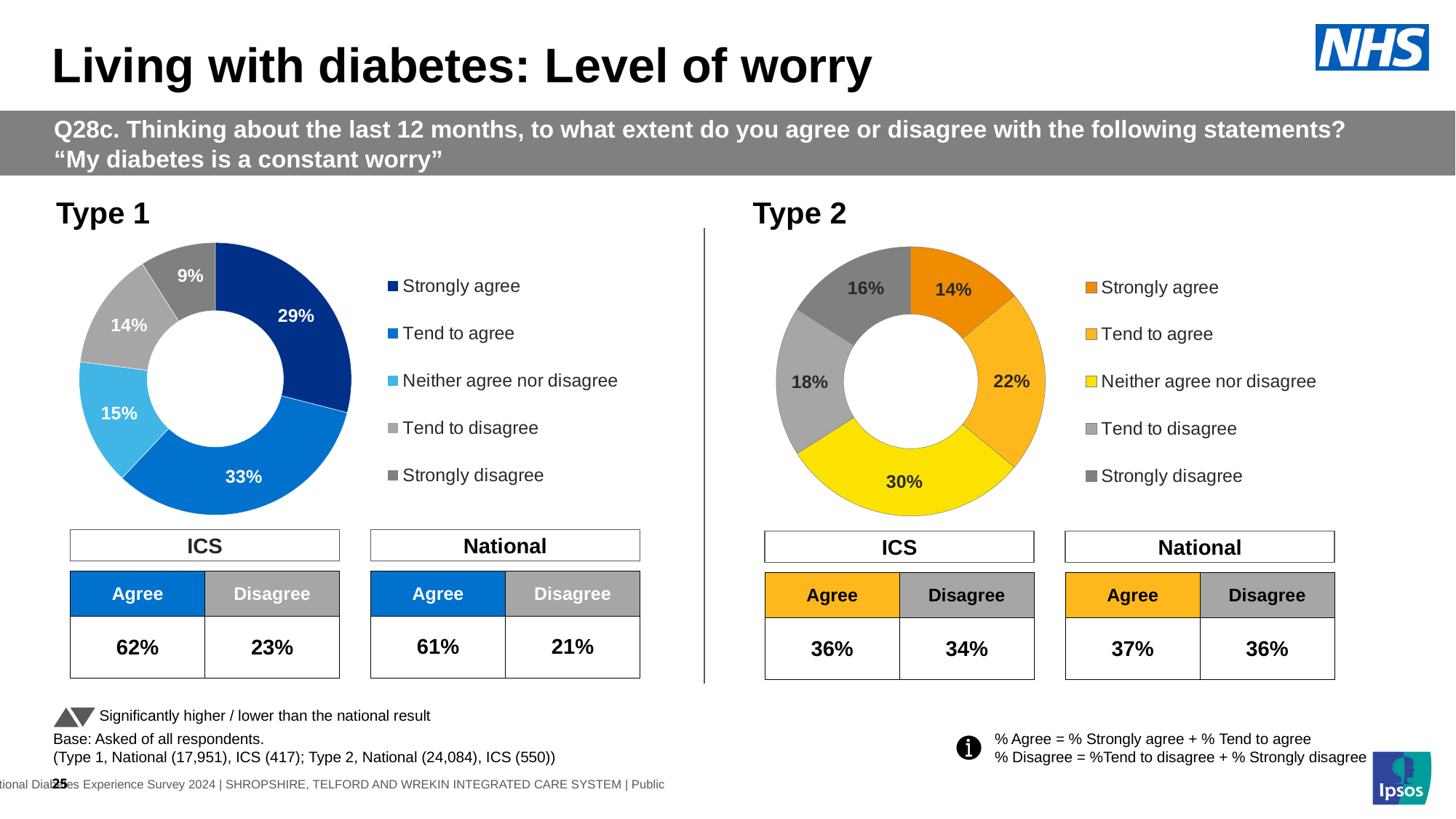
How many entries does the legend of the Type 2 chart list? 5 In the Type 1 chart, what share of the pie is Tend to disagree? 14% In the Type 2 chart, which is larger: Tend to agree or Tend to disagree? Tend to agree In the Type 1 chart, what is the difference between the Tend to agree and Strongly disagree percentages? 24% In the Type 1 chart, which category has the largest share? Tend to agree What kind of chart is the Type 2 chart? Doughnut (pie) chart In the Type 1 chart, what percentage is shown for Strongly agree? 29% In the Type 2 chart, which category has the smallest share? Strongly agree In the Type 2 chart, what is the combined share of Strongly agree and Tend to agree? 36% In the Type 2 chart, what percentage is shown for Neither agree nor disagree? 30% In the Type 1 chart, what colour is the Neither agree nor disagree slice? Light blue How many categories does the Type 1 chart show? 5